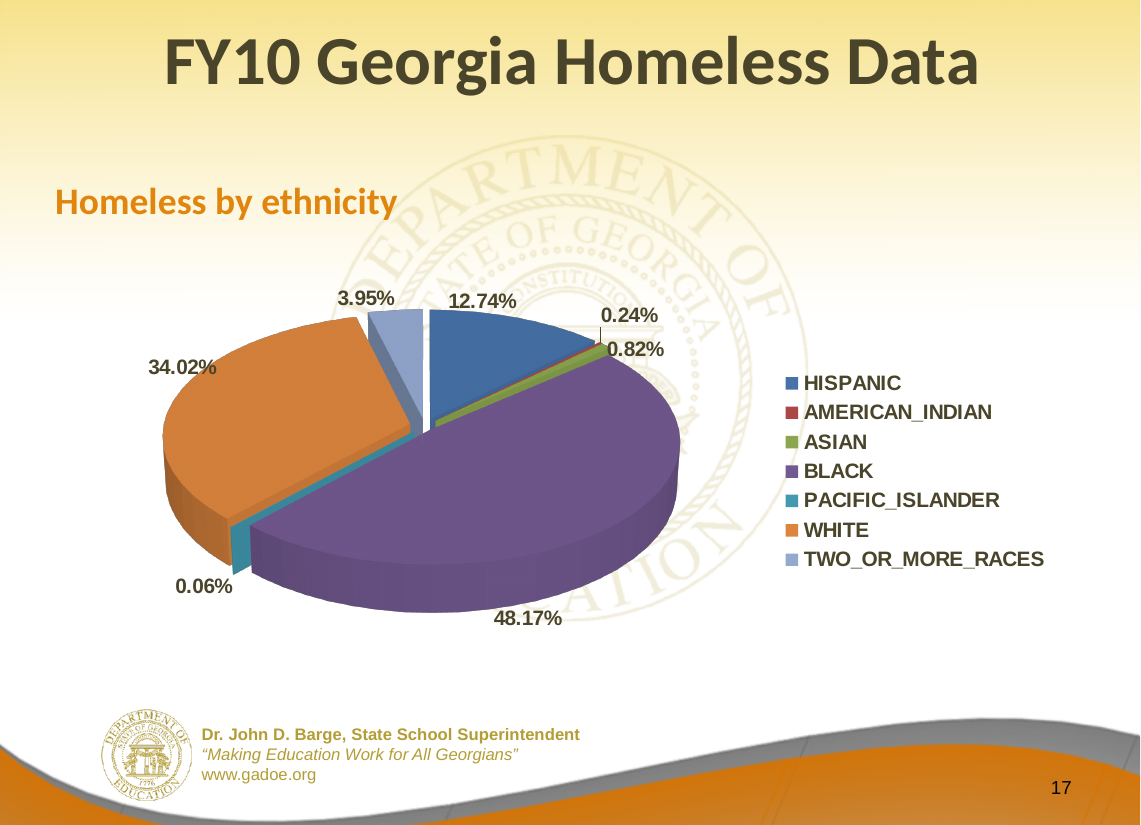
What is the subtitle of the chart on the slide? Homeless by ethnicity Which ethnicity has the largest share of the pie? BLACK What share of the pie does HISPANIC represent? 12.74% Which has a larger share, ASIAN or AMERICAN_INDIAN? ASIAN What share of the pie does TWO_OR_MORE_RACES represent? 3.95% What share of the pie does PACIFIC_ISLANDER represent? 0.06% What share of the pie does BLACK represent? 48.17% Which ethnicity has the smallest share of the pie? PACIFIC_ISLANDER How many ethnicity categories does the pie chart show? 7 What is the difference in percentage points between the BLACK and WHITE shares? 14.15 What kind of chart is shown on the slide? Pie chart What share of the pie does WHITE represent? 34.02%